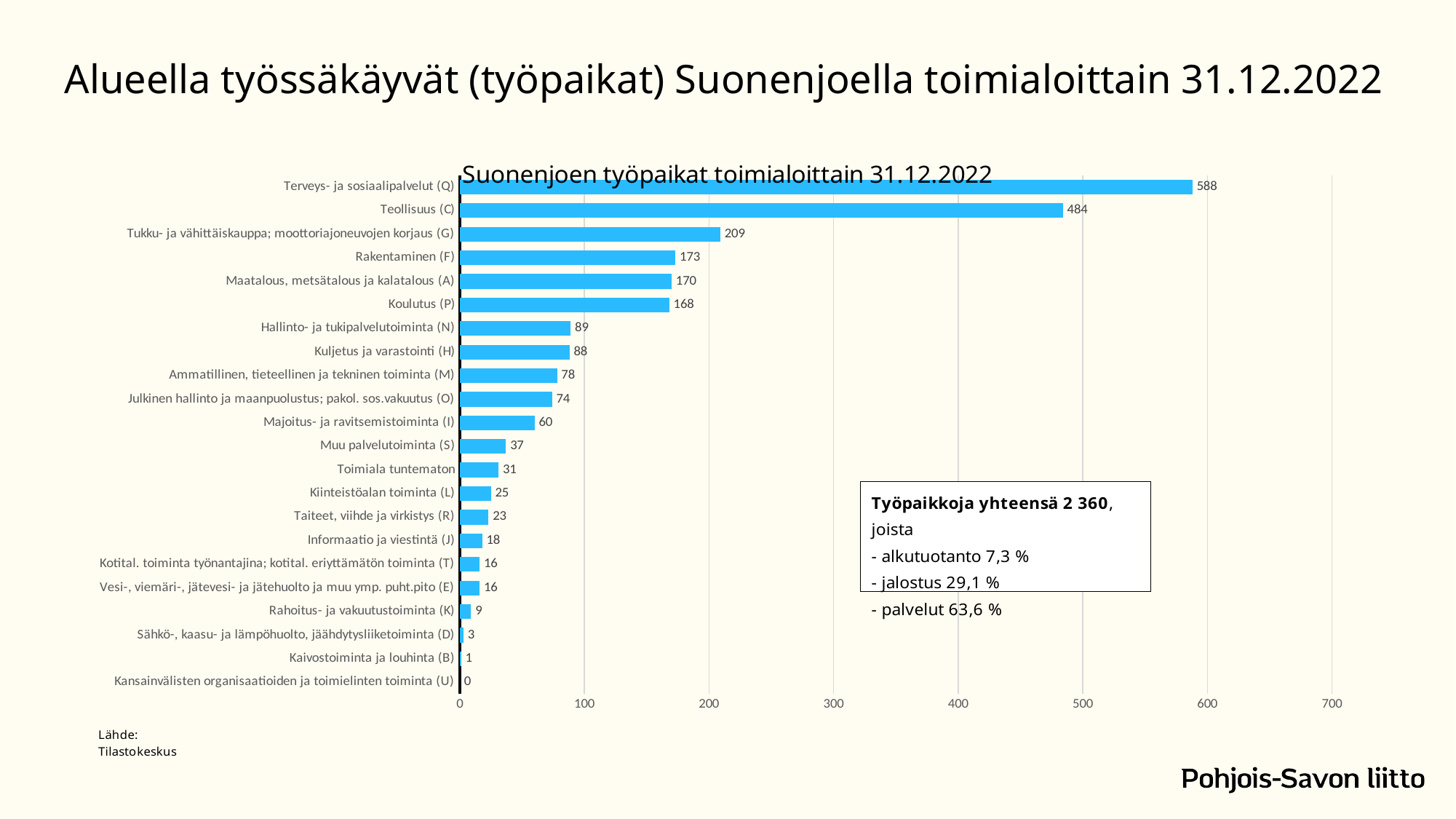
What is the value for Majoitus- ja ravitsemistoiminta (I)? 60 Which category has the highest value? Terveys- ja sosiaalipalvelut (Q) Which is larger, Rakentaminen (F) or Maatalous, metsätalous ja kalatalous (A)? Rakentaminen (F) What is the value for Koulutus (P)? 168 What is the value for Teollisuus (C)? 484 What kind of chart is shown? bar chart How many categories are shown in the chart? 22 What is the title of the chart? Suonenjoen työpaikat toimialoittain 31.12.2022 What is the value for Rahoitus- ja vakuutustoiminta (K)? 9 What is the difference between Terveys- ja sosiaalipalvelut (Q) and Teollisuus (C)? 104 Is the value for Tukku- ja vähittäiskauppa; moottoriajoneuvojen korjaus (G) greater or less than 200? greater Which category has the lowest value? Kansainvälisten organisaatioiden ja toimielinten toiminta (U)